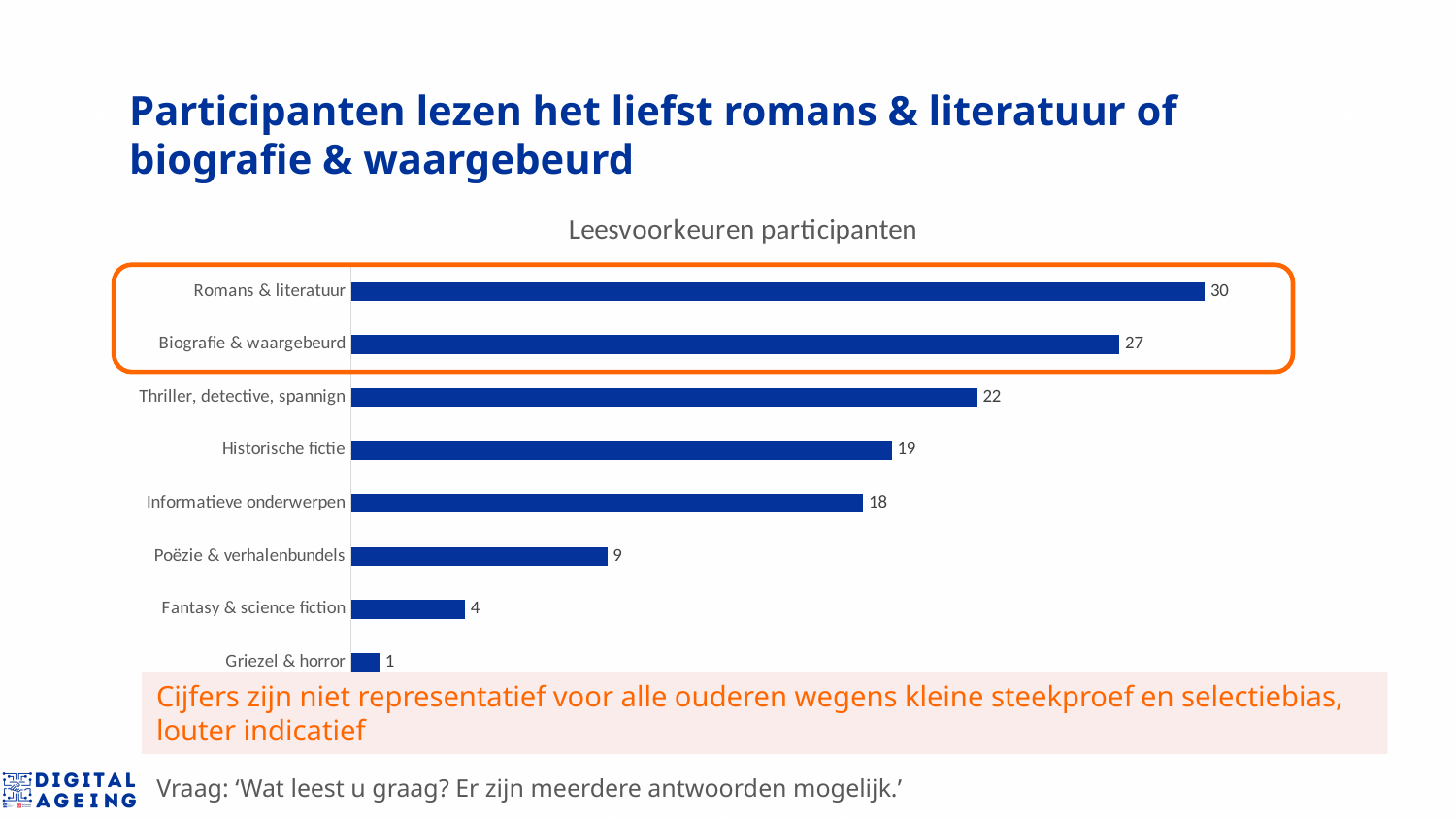
Which category has the lowest value? Griezel & horror How many categories are shown in the chart? 8 What kind of chart is shown on the slide? Bar chart What is the difference between the values for Thriller, detective, spannign and Poëzie & verhalenbundels? 13 What is the value for Fantasy & science fiction? 4 Which is larger, the value for Historische fictie or the value for Informatieve onderwerpen? Historische fictie Which category has the highest value? Romans & literatuur What is the difference between the values for Romans & literatuur and Biografie & waargebeurd? 3 Which two categories are highlighted with an orange outline? Romans & literatuur and Biografie & waargebeurd What is the title of the chart? Leesvoorkeuren participanten What is the value for Romans & literatuur? 30 What is the value for Historische fictie? 19